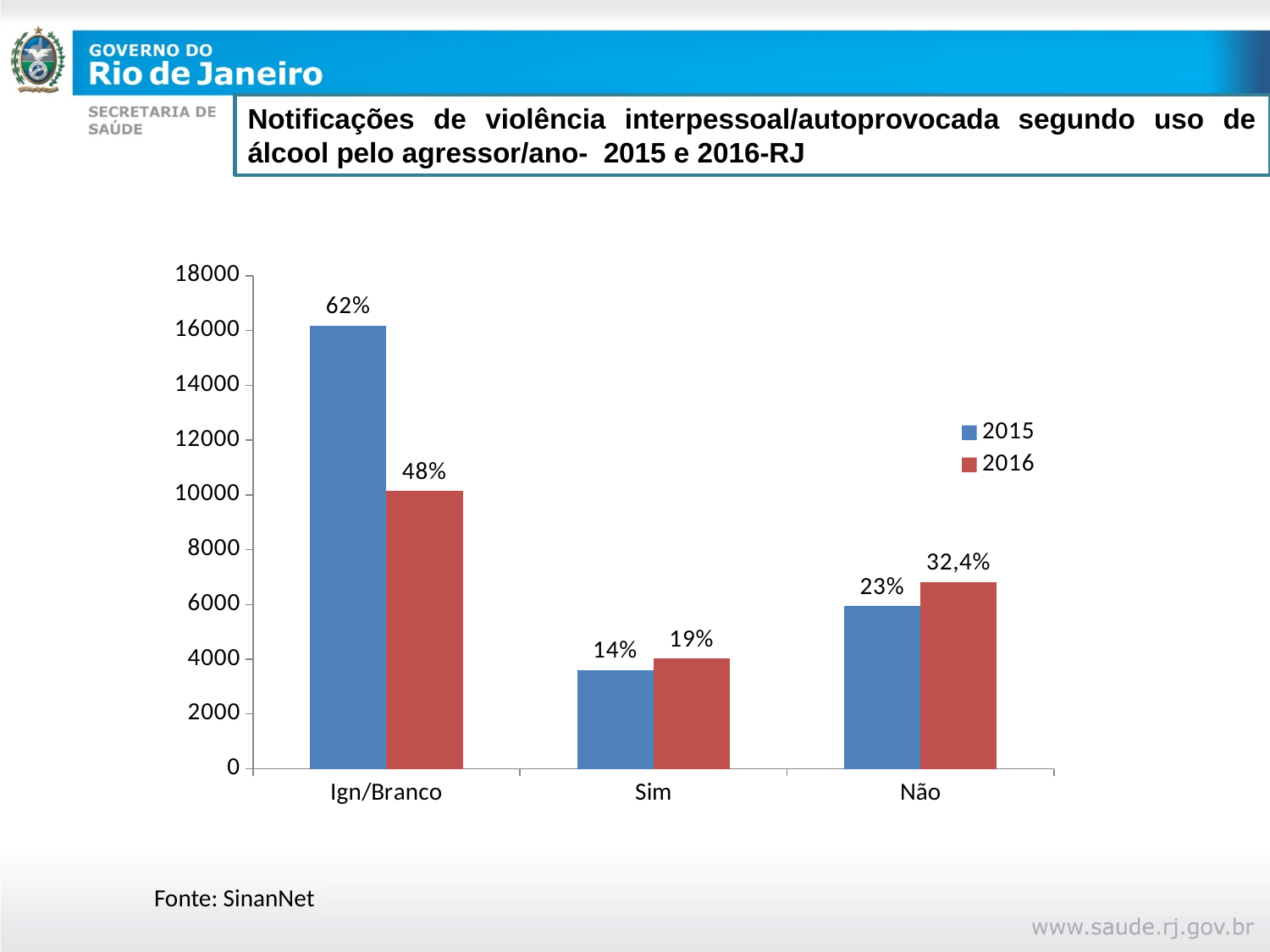
What data label is shown on the 2016 bar for Sim? 19% How many categories are shown on the x axis? 3 For Ign/Branco, which year has the taller bar, 2015 or 2016? 2015 Is the 2016 bar for Sim greater or less than 6000? less For Não, which year has the taller bar, 2015 or 2016? 2016 What data label is shown on the 2016 bar for Não? 32,4% What data label is shown on the 2015 bar for Não? 23% What data label is shown on the 2015 bar for Ign/Branco? 62% Is the 2015 bar for Ign/Branco greater or less than 14000? greater Which category has the tallest 2015 bar? Ign/Branco How many series does the legend list? 2 Which category has the shortest 2016 bar? Sim